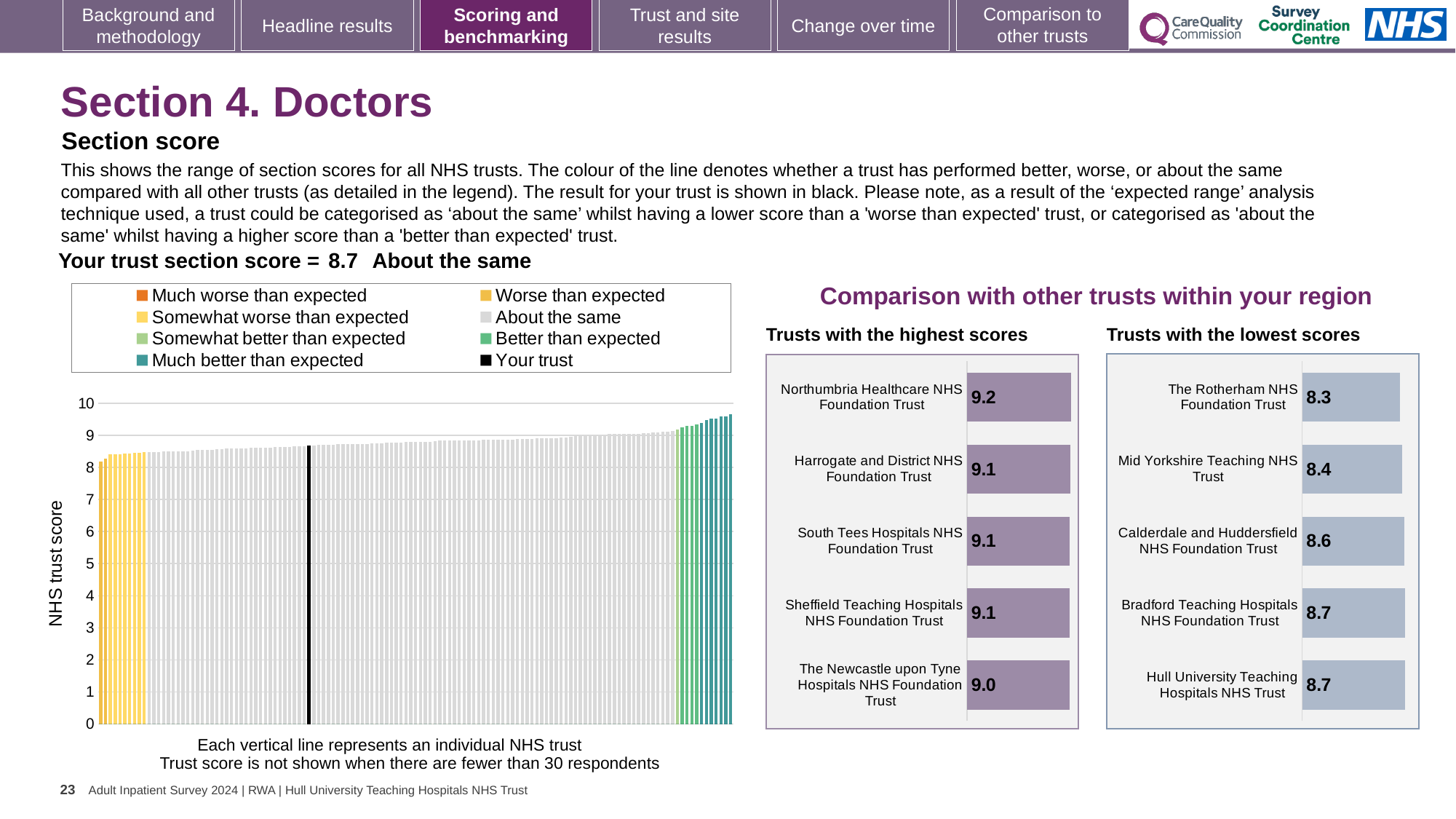
In the 'Trusts with the lowest scores' chart, what is the difference between the scores of Hull University Teaching Hospitals NHS Trust and The Rotherham NHS Foundation Trust? 0.4 How many trusts are shown in the 'Trusts with the highest scores' chart? 5 In the 'Trusts with the highest scores' chart, what is the difference between the scores of Northumbria Healthcare NHS Foundation Trust and The Newcastle upon Tyne Hospitals NHS Foundation Trust? 0.2 In the large chart on the left, do the trust scores rise or fall from left to right? Rise In the 'Trusts with the lowest scores' chart, which has the larger score: Mid Yorkshire Teaching NHS Trust or Calderdale and Huddersfield NHS Foundation Trust? Calderdale and Huddersfield NHS Foundation Trust In the 'Trusts with the highest scores' chart, what is the score for Northumbria Healthcare NHS Foundation Trust? 9.2 In the 'Trusts with the highest scores' chart, what is the score for The Newcastle upon Tyne Hospitals NHS Foundation Trust? 9.0 In the 'Trusts with the lowest scores' chart, which trust has the lowest score? The Rotherham NHS Foundation Trust In the 'Trusts with the highest scores' chart, which trust has the highest score? Northumbria Healthcare NHS Foundation Trust How many entries does the legend of the large chart on the left list? 8 What kind of chart is the large chart on the left showing NHS trust scores? Bar chart In the 'Trusts with the lowest scores' chart, what is the score for The Rotherham NHS Foundation Trust? 8.3